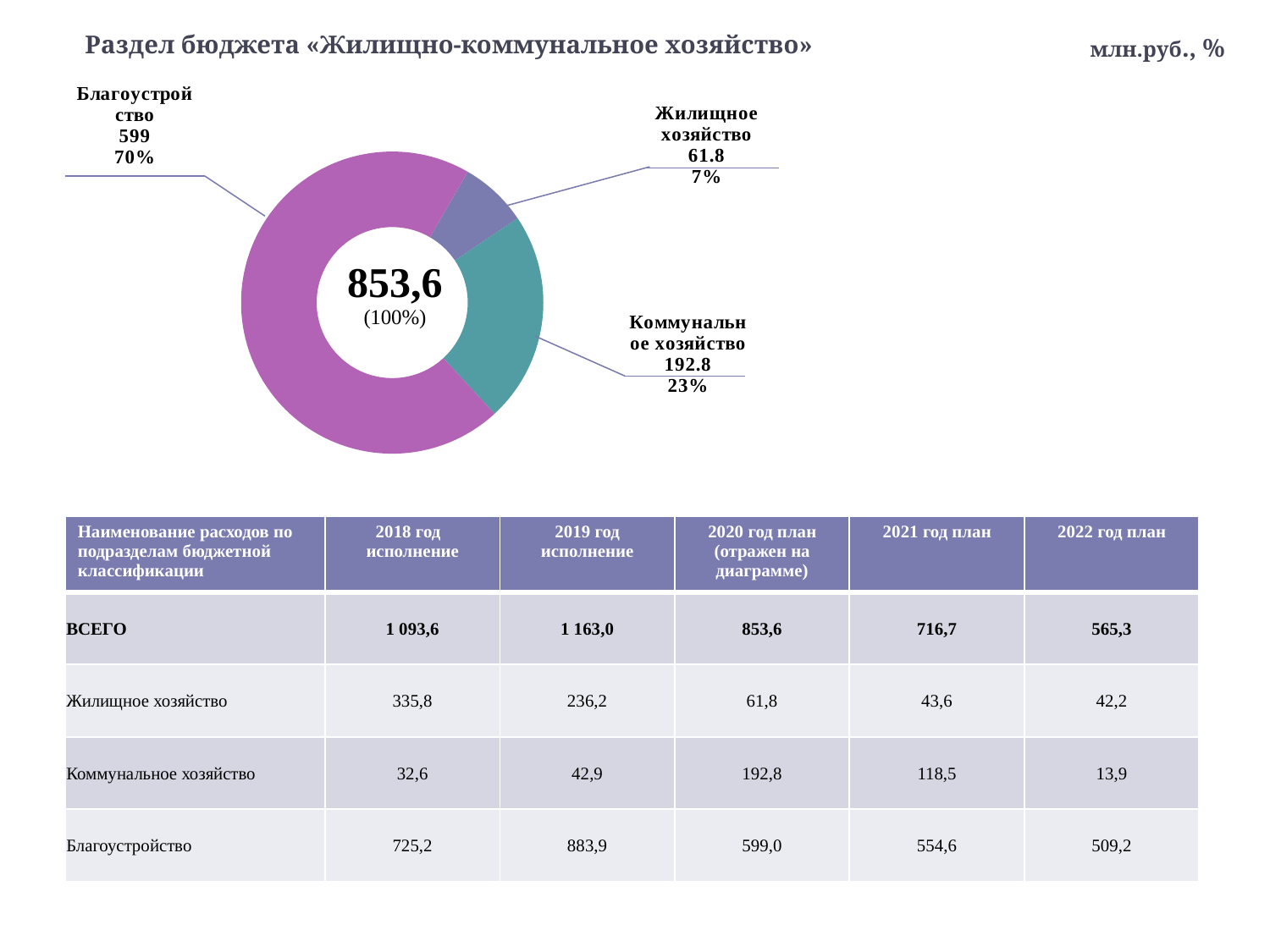
Which category has the smallest slice in the chart? Жилищное хозяйство What share of the chart does Коммунальное хозяйство take? 23% What total value is shown in the centre of the chart? 853,6 How many categories are shown in the chart? 3 What is the value shown for Коммунальное хозяйство on the chart? 192.8 What kind of chart is shown on the slide? Pie (donut) chart What is the value shown for Благоустройство on the chart? 599 What share of the chart does Благоустройство take? 70% What is the value shown for Жилищное хозяйство on the chart? 61.8 Which is larger in the chart, Коммунальное хозяйство or Жилищное хозяйство? Коммунальное хозяйство What share of the chart does Жилищное хозяйство take? 7% Which category has the largest slice in the chart? Благоустройство